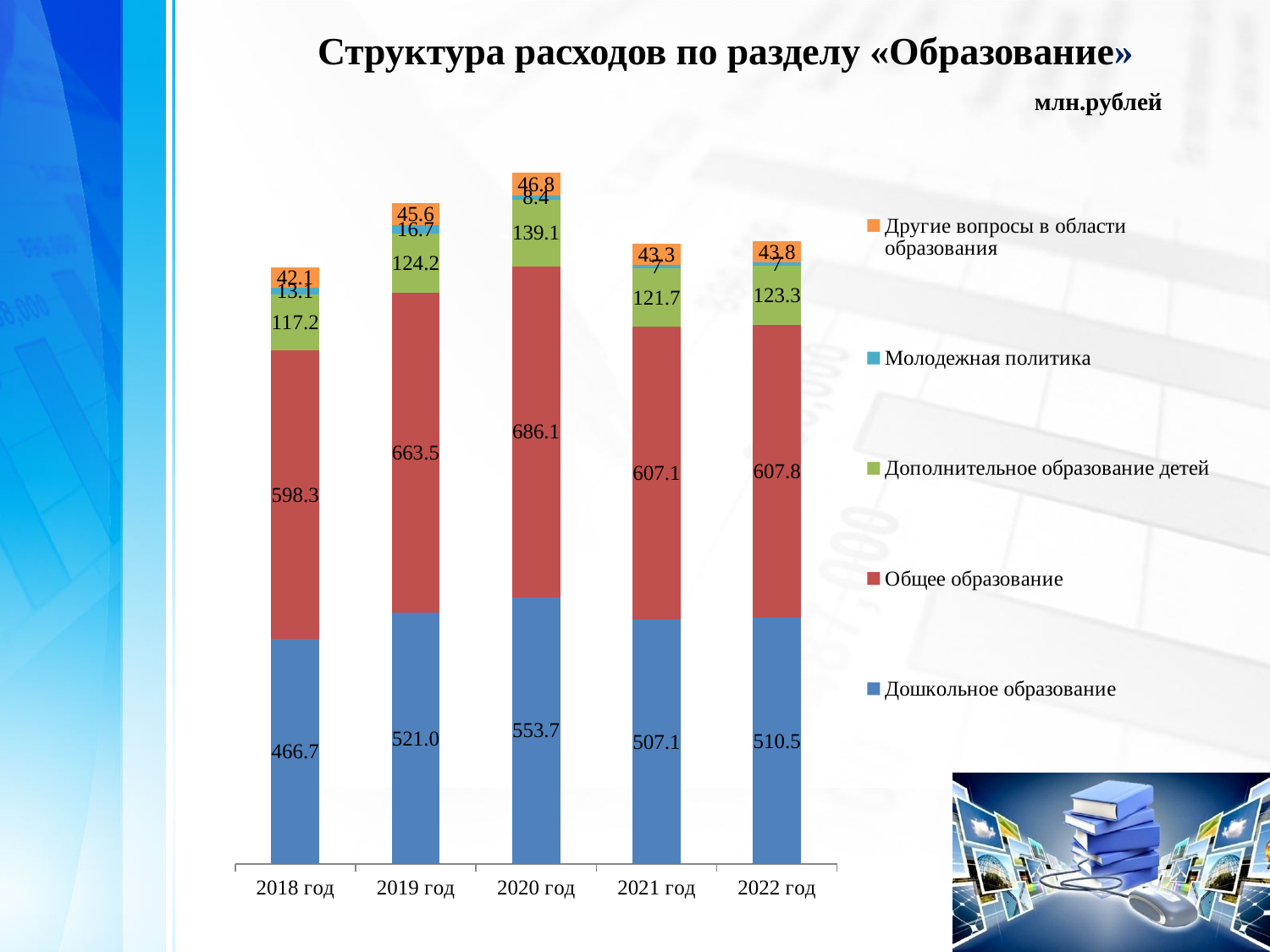
What unit is stated for the values on the chart? млн.рублей How many series does the legend list? 5 How many years are shown on the x axis? 5 In which year is the value for Дошкольное образование the lowest? 2018 год What is the value for Дополнительное образование детей in 2022 год? 123.3 What is the value for Дошкольное образование in 2020 год? 553.7 What is the value for Общее образование in 2019 год? 663.5 What is the total of the stacked bar for 2018 год? 1237.4 What is the difference between Общее образование in 2020 год and in 2018 год? 87.8 Which is larger: Дошкольное образование in 2021 год or in 2022 год? 2022 год What type of chart is shown on the slide? stacked bar chart In which year is the value for Общее образование the highest? 2020 год